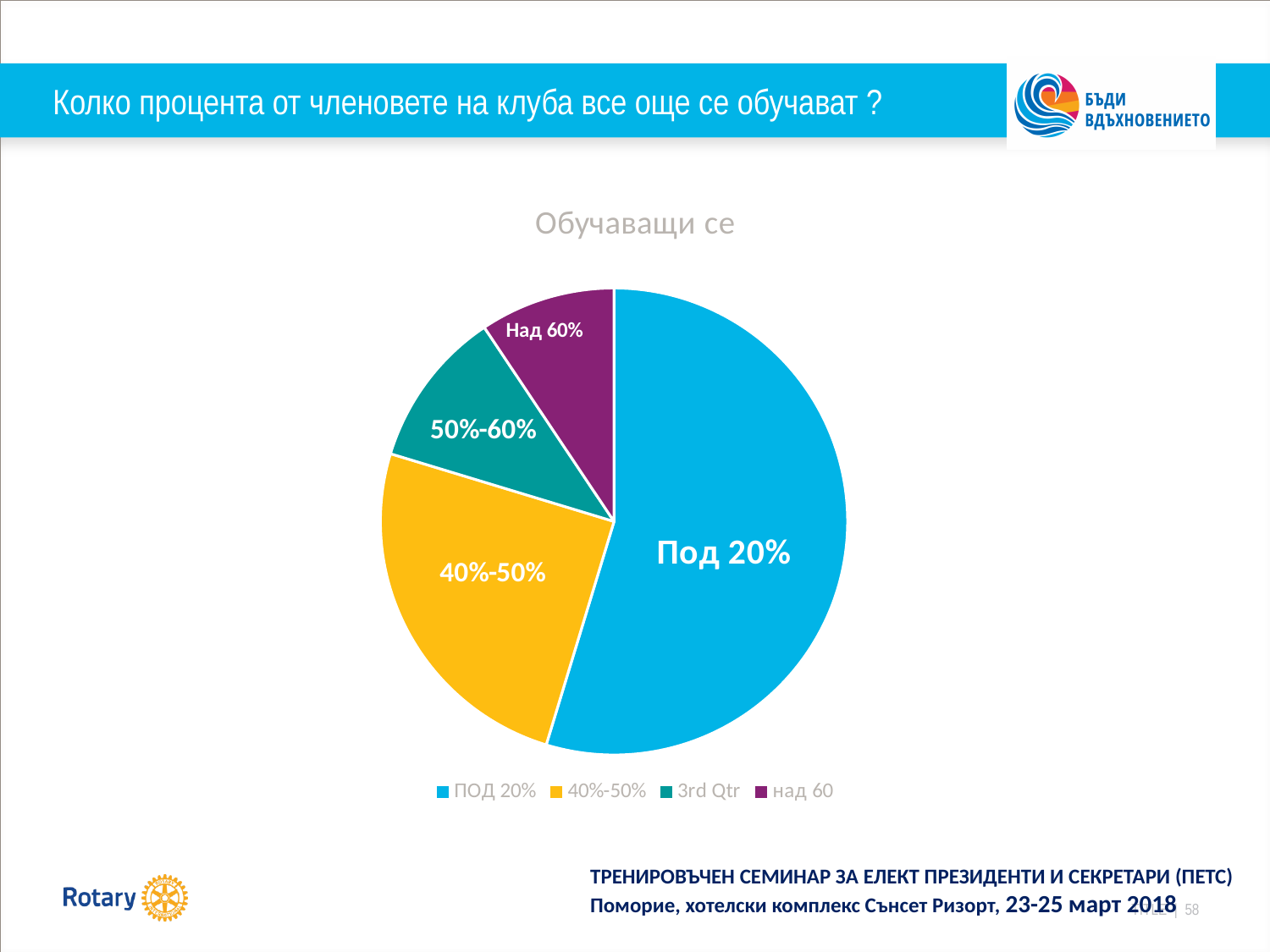
Which slice is larger, 40%-50% or Над 60%? 40%-50% How many entries does the legend list? 4 Which slice is larger, Под 20% or 40%-50%? Под 20% How many slices does the pie chart have? 4 What kind of chart is shown on the slide? pie chart Which slice is larger, 40%-50% or 50%-60%? 40%-50% What is the title of the chart? Обучаващи се Which slice of the pie chart is the largest? Под 20% What colour is the Под 20% slice? blue